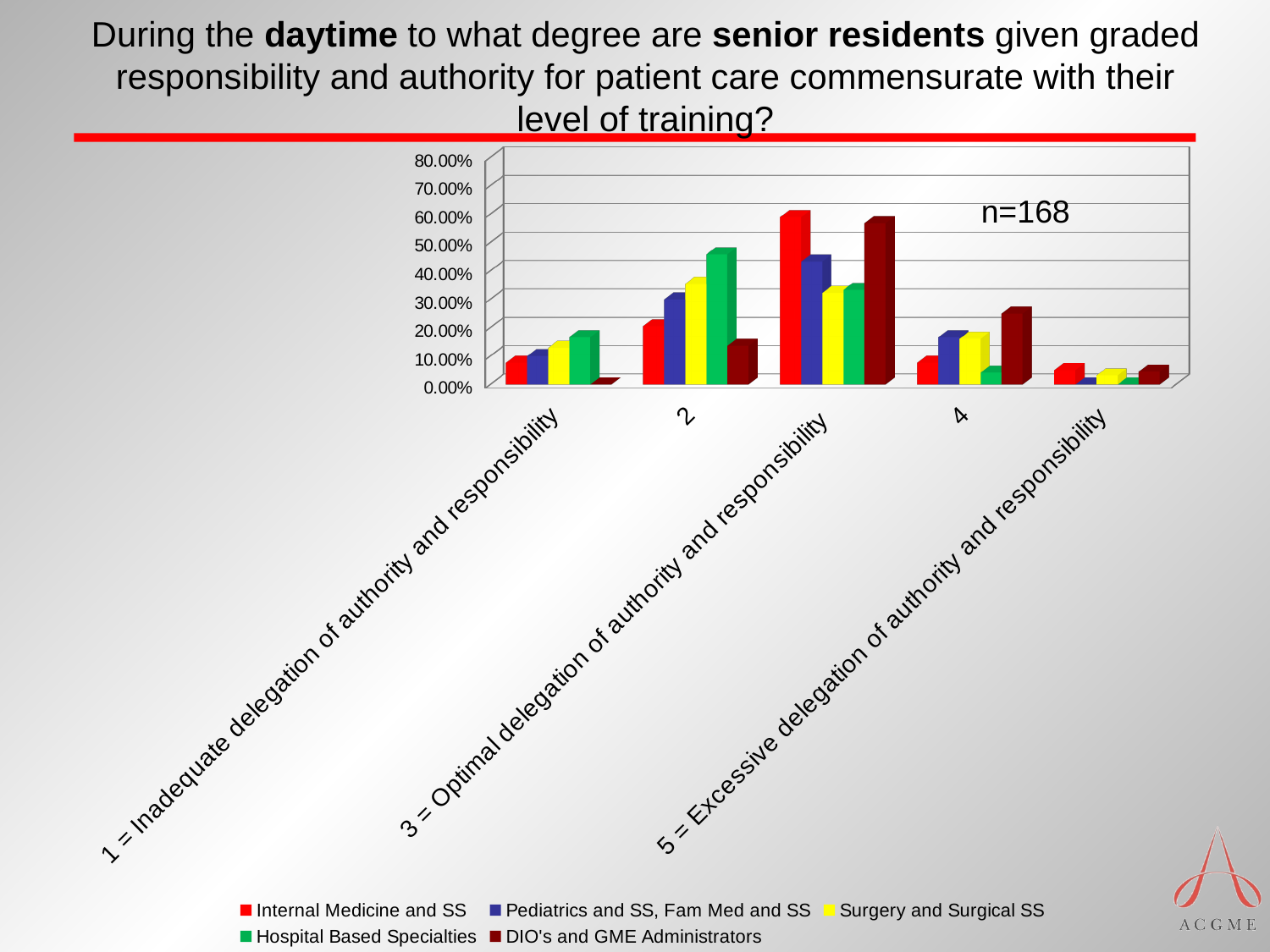
At '3 = Optimal delegation of authority and responsibility', which is larger: Internal Medicine and SS or Pediatrics and SS, Fam Med and SS? Internal Medicine and SS What kind of chart is shown on the slide? bar chart Which series has the highest value at category 2? Hospital Based Specialties What sample size (n) is shown on the chart? n=168 How many response categories are shown along the x axis? 5 Is the value for Internal Medicine and SS at '3 = Optimal delegation of authority and responsibility' greater or less than 50.00%? greater Is the value for Hospital Based Specialties at category 2 greater or less than 40.00%? greater For Internal Medicine and SS, which category has the highest value? 3 = Optimal delegation of authority and responsibility Is the value for Pediatrics and SS, Fam Med and SS at category 2 greater or less than 40.00%? less How many series does the legend list? 5 Which series has the lowest value at '1 = Inadequate delegation of authority and responsibility'? DIO's and GME Administrators